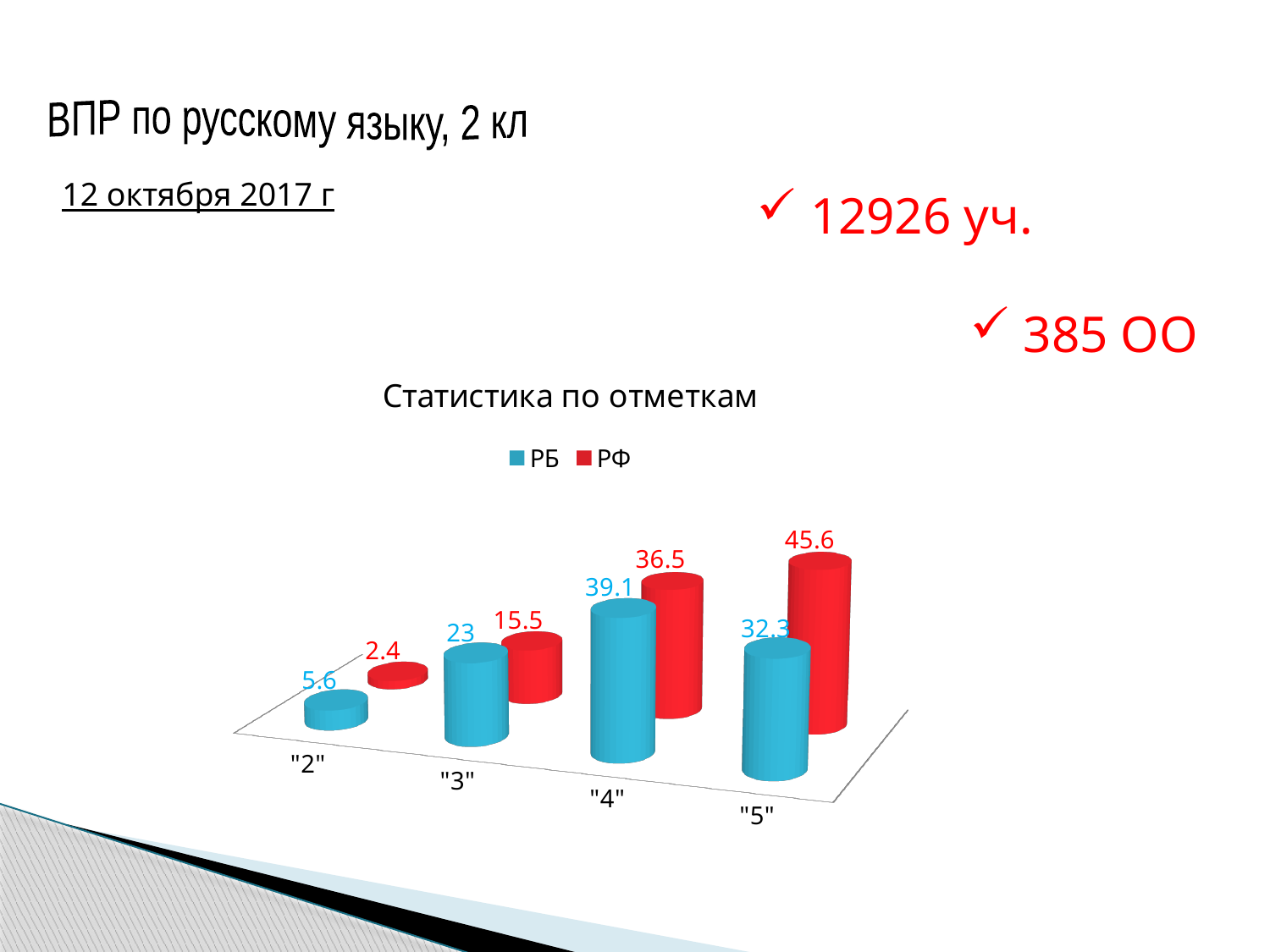
What kind of chart is shown on the slide? Bar chart What is the value for РФ at mark "5"? 45.6 What is the value for РБ at mark "2"? 5.6 Which mark has the lowest value for the РФ series? "2" Which mark has the highest value for the РБ series? "4" How many series does the legend list? 2 What is the title of the chart? Статистика по отметкам What is the value for РФ at mark "3"? 15.5 What is the difference between РФ and РБ at mark "5"? 13.3 Which is larger at mark "3": РБ or РФ? РБ What is the value for РБ at mark "4"? 39.1 How many marks (categories) are shown on the x axis? 4